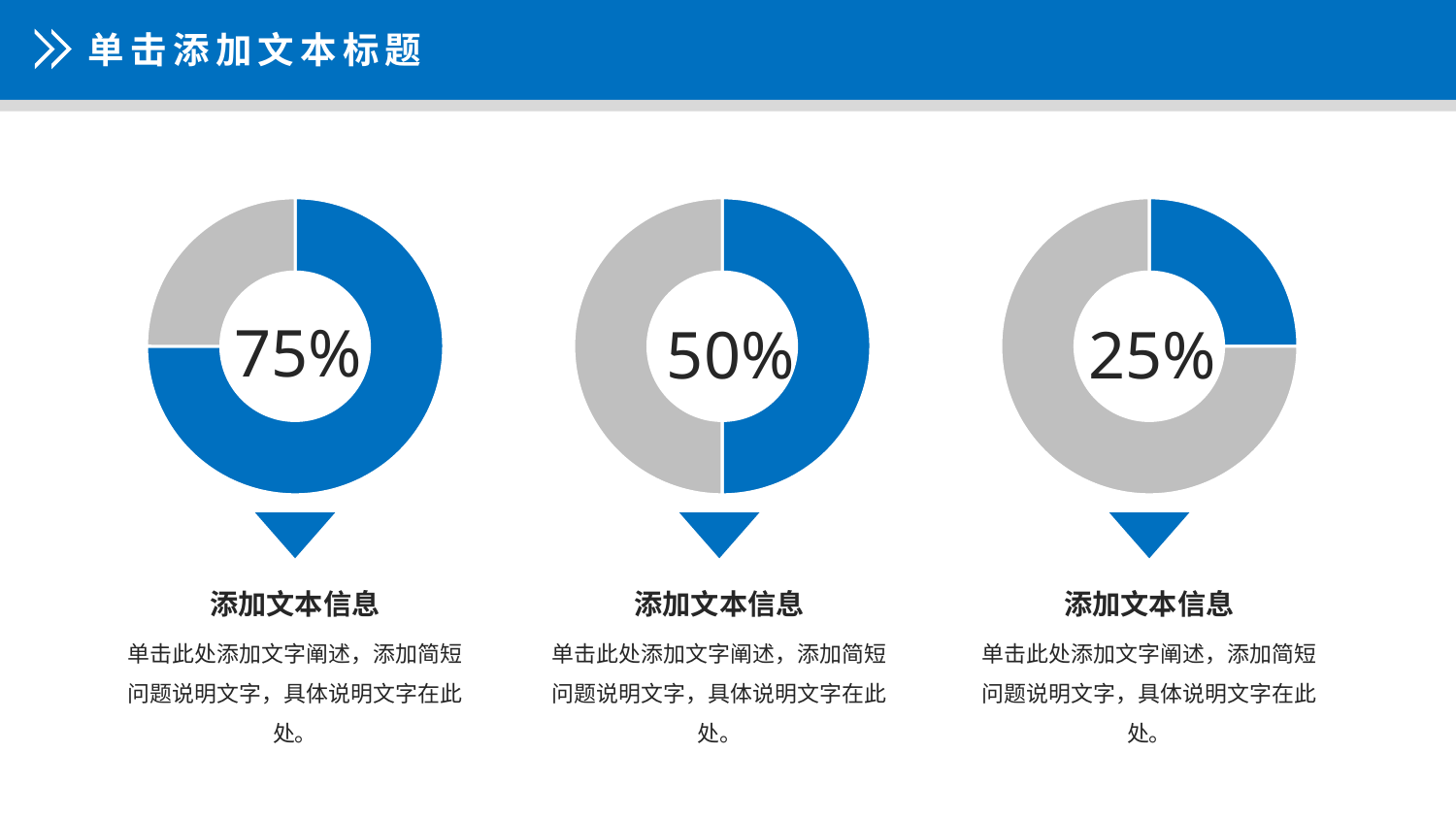
What kind of chart is used for each of the three charts on the slide? Donut chart What value is shown in the centre of the right donut chart? 25% What value is shown in the centre of the middle donut chart? 50% What two colours are used for the segments of the donut charts? Blue and grey What is the difference between the percentage in the left donut chart and the percentage in the middle donut chart? 25% Which of the three donut charts shows the lowest percentage? The right chart (25%) What value is shown in the centre of the left donut chart? 75% Is the value shown in the middle donut chart greater or less than 75%? less In the right donut chart, what share of the ring is filled in blue? 25% How many donut charts are on the slide? 3 Which of the three donut charts shows the highest percentage? The left chart (75%) Is the percentage in the left donut chart larger or smaller than the percentage in the right donut chart? Larger